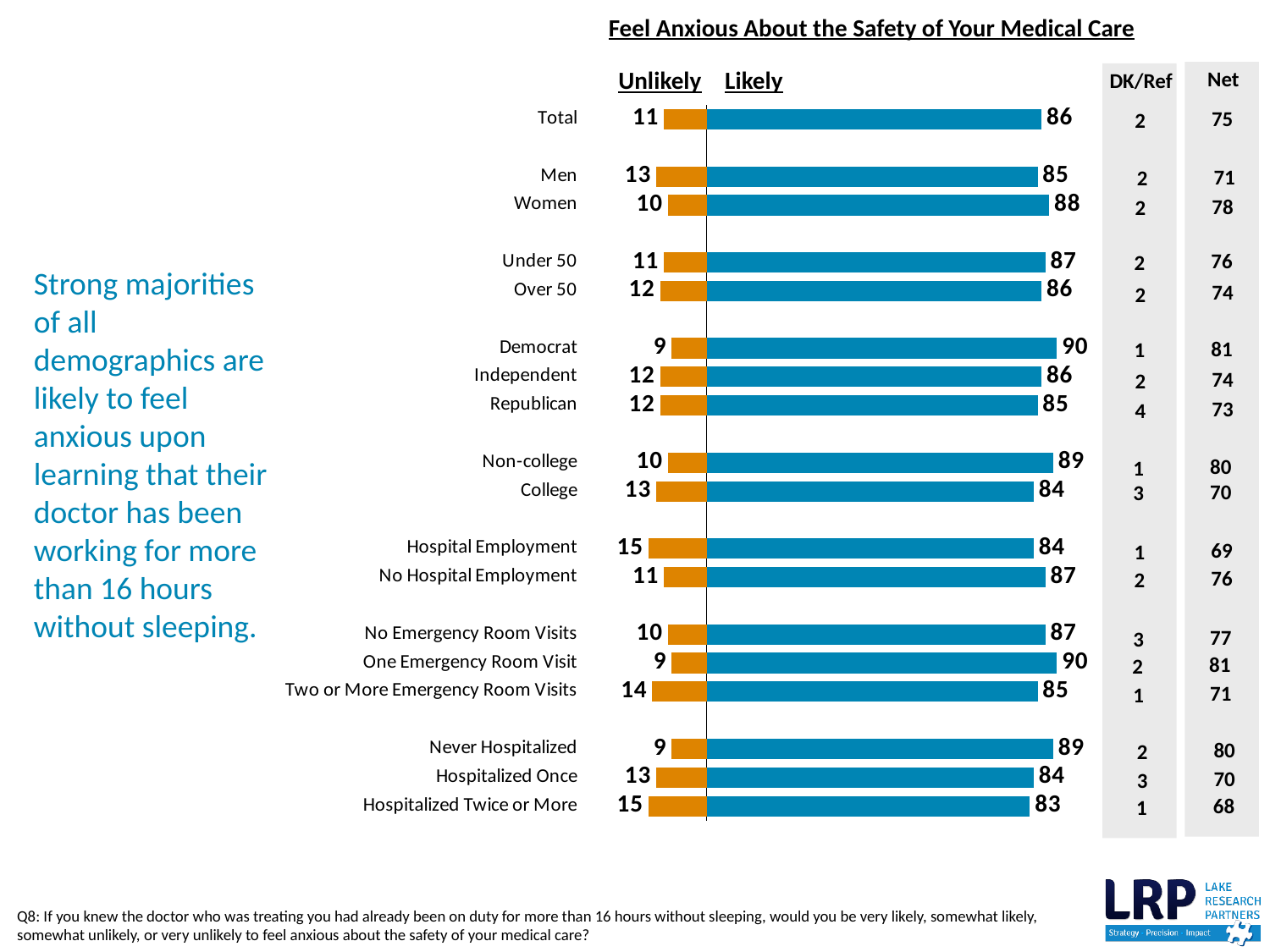
What is the Unlikely value for Hospital Employment? 15 What is the Likely value for Total? 86 What is the Likely value for Democrat? 90 Which category has the lowest Likely value? Hospitalized Twice or More What is the difference between the Likely values for Women and Men? 3 How many categories are plotted in the chart? 18 What type of chart is shown on the slide? Bar chart Which has a larger Unlikely value, Two or More Emergency Room Visits or One Emergency Room Visit? Two or More Emergency Room Visits How many series does the chart show? 2 What is the difference between the Likely values for Democrat and Republican? 5 Among the hospitalization categories (Never Hospitalized, Hospitalized Once, Hospitalized Twice or More), which has the highest Likely value? Never Hospitalized Which has a larger Likely value, Non-college or College? Non-college